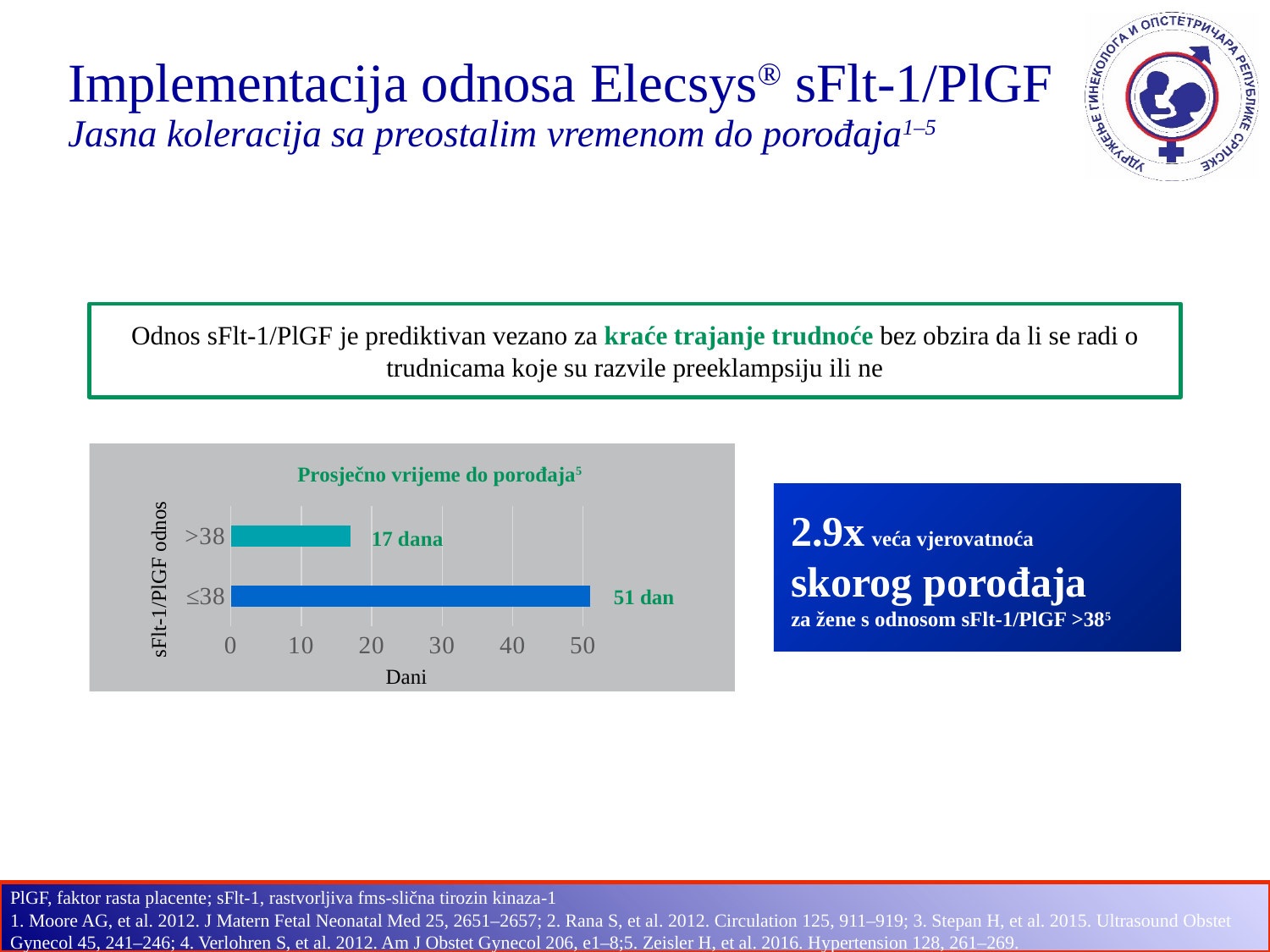
How many days longer is the average time to delivery for the ≤38 group than for the >38 group? 34 What is the label of the x axis of the chart? Dani What is the title of the chart? Prosječno vrijeme do porođaja Is the average time to delivery larger for the >38 group or the ≤38 group? ≤38 What kind of chart is shown on the slide? bar chart Which sFlt-1/PlGF ratio group has the longer average time to delivery? ≤38 What is the average time to delivery for the sFlt-1/PlGF ratio >38 group? 17 dana What is the average time to delivery for the sFlt-1/PlGF ratio ≤38 group? 51 dan Which sFlt-1/PlGF ratio group has the shorter average time to delivery? >38 Is the value for the ≤38 group greater or less than 40 days? greater Is the value for the >38 group greater or less than 20 days? less How many categories are shown in the chart? 2